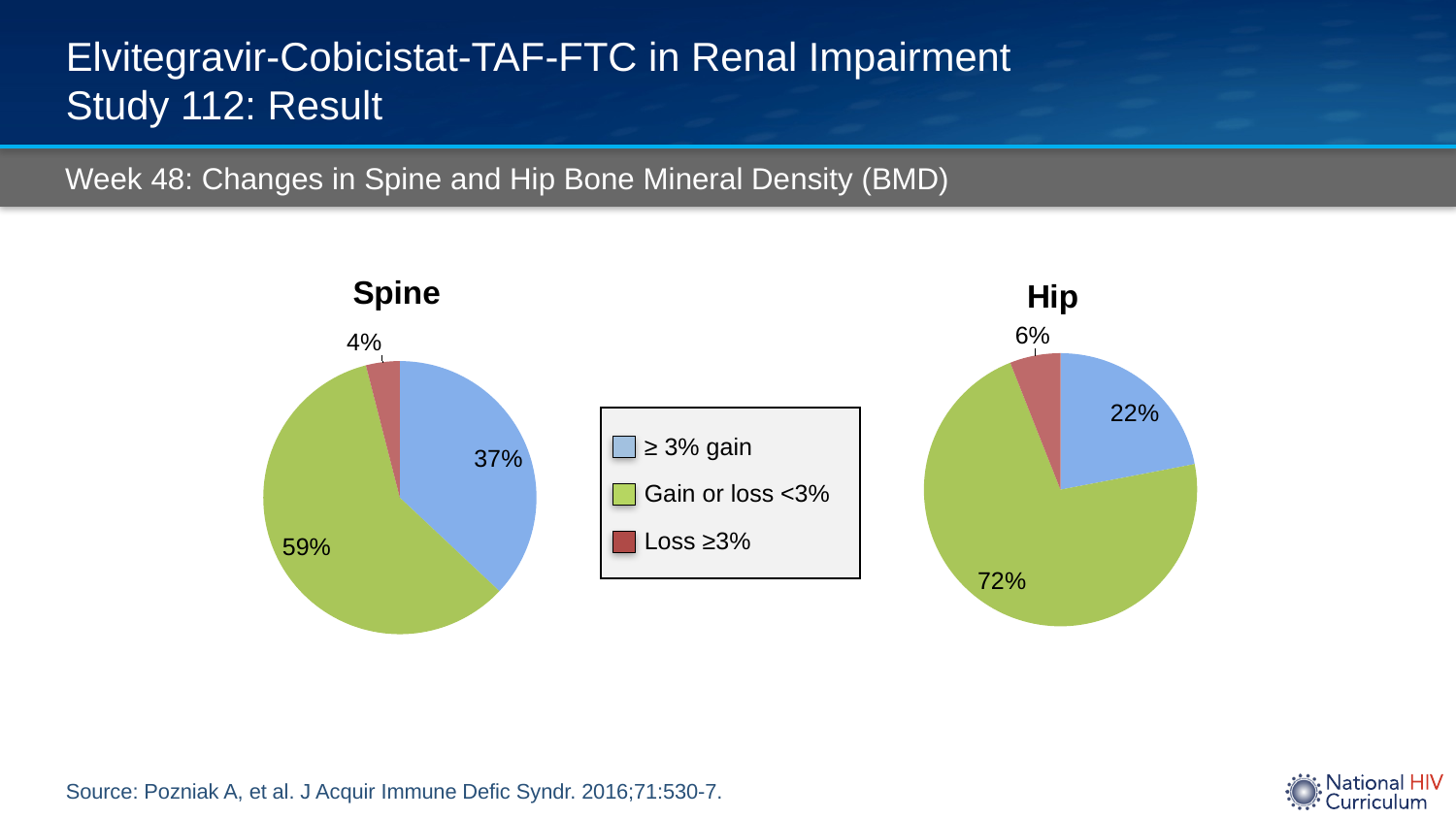
In the Spine pie chart, which category has the largest share? Gain or loss <3% In the Hip pie chart, which category has the smallest share? Loss ≥3% In the Hip pie chart, what percentage of participants had a gain or loss <3%? 72% What is the difference between the ≥ 3% gain share in the Spine chart and the ≥ 3% gain share in the Hip chart? 15% In the Spine pie chart, what is the difference between the Gain or loss <3% share and the ≥ 3% gain share? 22% How many categories does the legend list? 3 In the Spine pie chart, what percentage of participants had a ≥ 3% gain in BMD? 37% Which is larger: the Gain or loss <3% share in the Spine chart or in the Hip chart? Hip What type of chart is used to show the Hip BMD changes? Pie chart In the Hip pie chart, what percentage of participants had a loss ≥3% in BMD? 6% Which colour represents Loss ≥3% in the legend? Red How many slices does the Spine pie chart have? 3